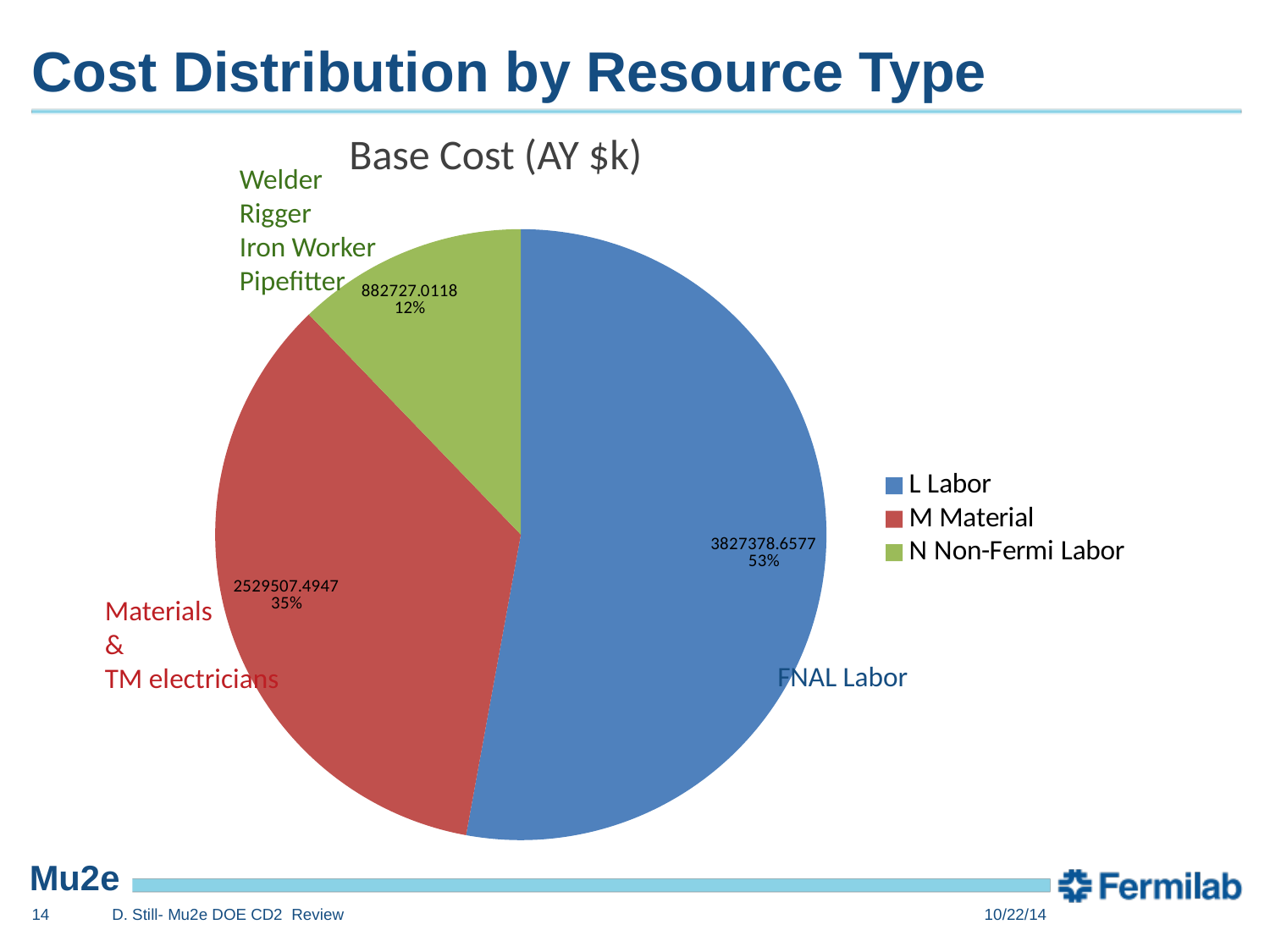
What share of the pie does N Non-Fermi Labor represent? 12% What is the title of the chart? Base Cost (AY $k) What is the value for M Material? 2529507.4947 What is the value for L Labor? 3827378.6577 What share of the pie does L Labor represent? 53% How many slices does the pie chart have? 3 Which category has the smallest slice? N Non-Fermi Labor What type of chart is shown on the slide? pie chart Which is larger, M Material or N Non-Fermi Labor? M Material Which category has the largest slice? L Labor What is the value for N Non-Fermi Labor? 882727.0118 How many series does the legend list? 3